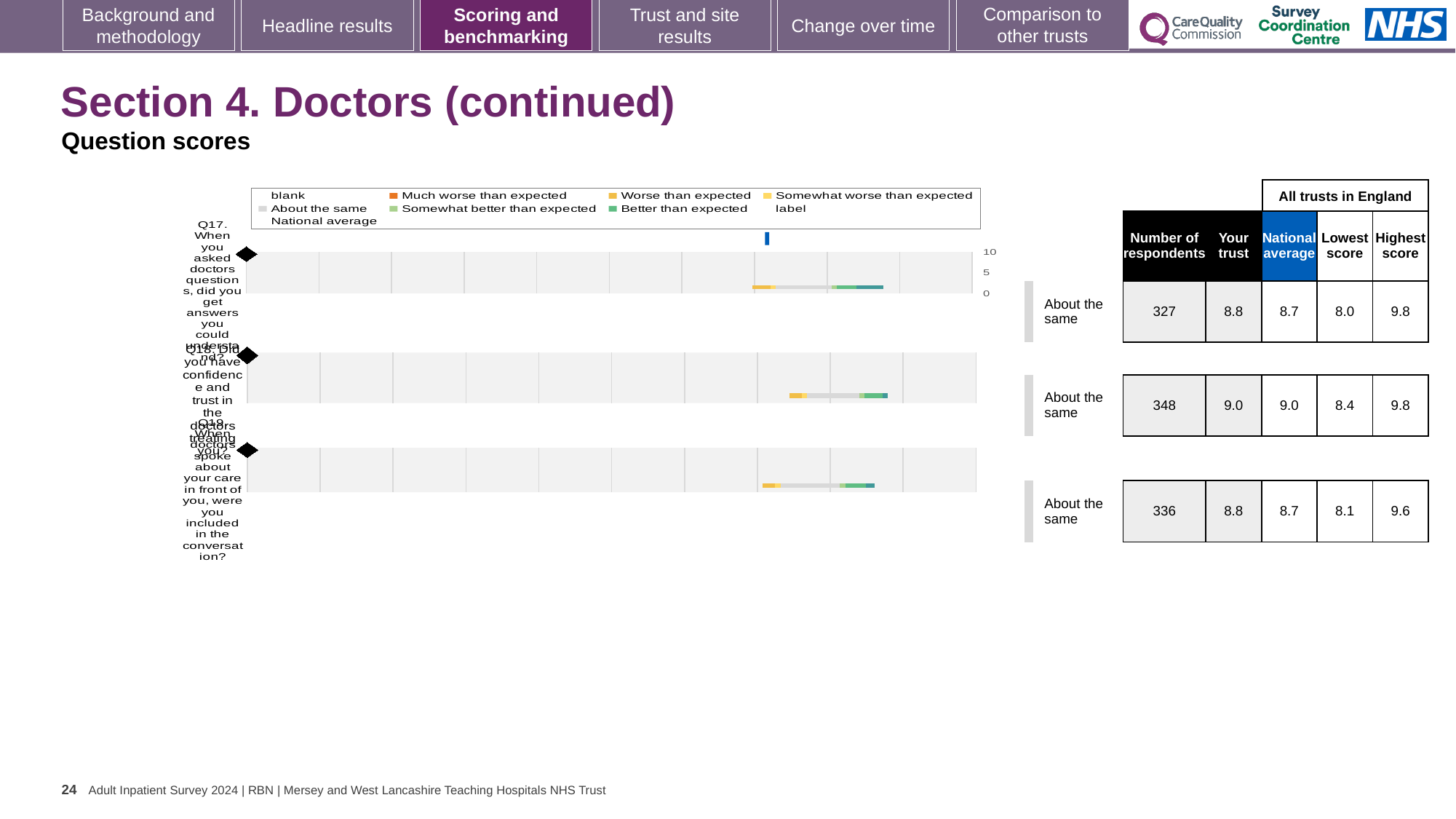
Which has the larger 'Your trust' score, Q18 or Q19? Q18 What kind of chart is used to show the question scores on this slide? bar chart What is the lowest score across all trusts in England for Q18? 8.4 How many questions are plotted in the question scores chart? 3 What is the 'Your trust' score for Q17 (When you asked doctors questions, did you get answers you could understand)? 8.8 What is the difference between the highest score and the lowest score for Q17? 1.8 What is the highest score across all trusts in England for Q19? 9.6 How many respondents answered Q19 (When doctors spoke about your care in front of you, were you included in the conversation)? 336 Which question has the highest 'Your trust' score? Q18 Which legend entry is shown in orange in the question scores chart? Much worse than expected What benchmark category is shown for Q17? About the same What is the national average score for Q18 (Did you have confidence and trust in the doctors treating you)? 9.0